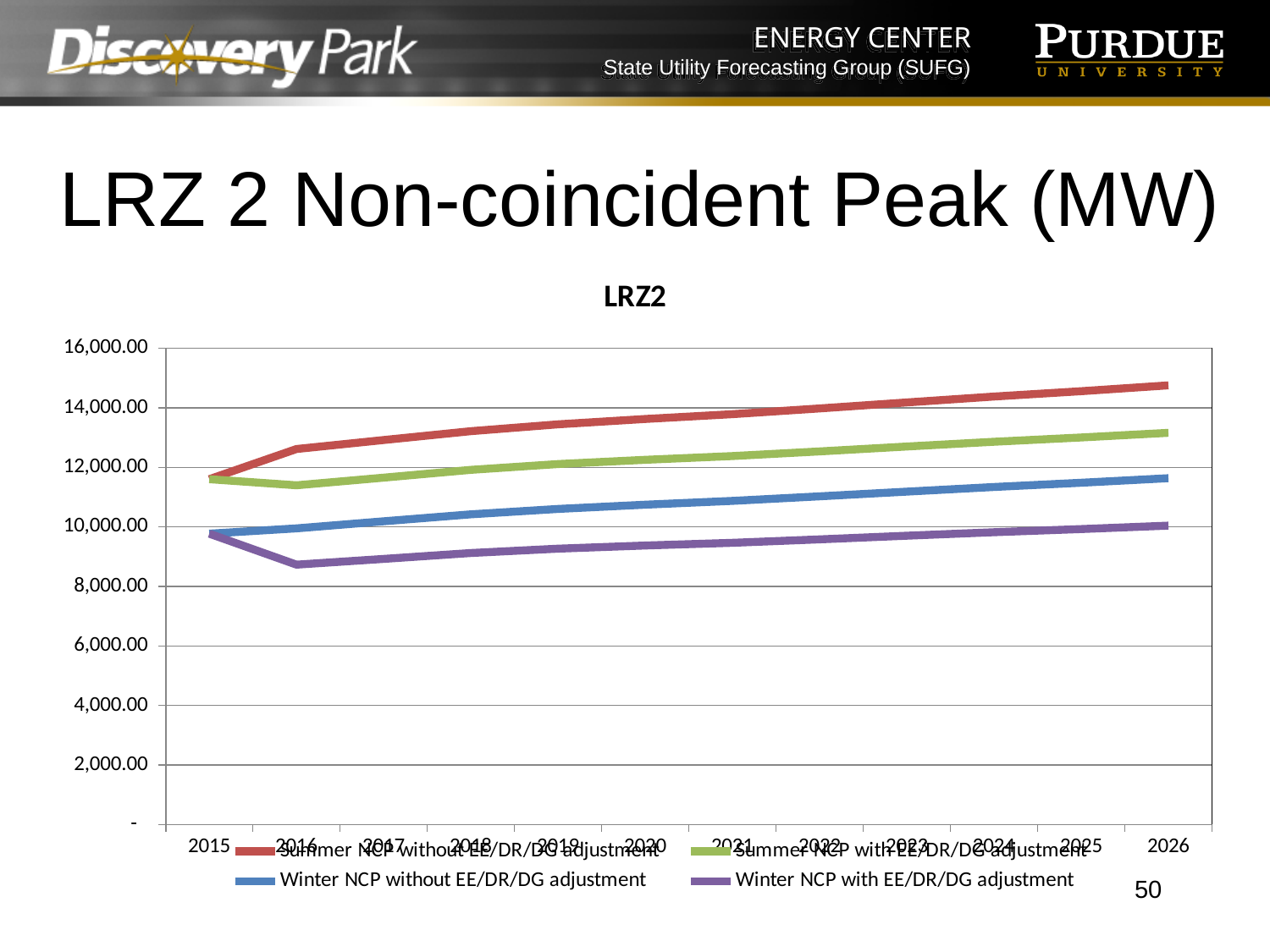
In 2026, which is larger: Summer NCP without EE/DR/DG adjustment or Winter NCP without EE/DR/DG adjustment? Summer NCP without EE/DR/DG adjustment Which series has the lowest values across the LRZ2 chart? Winter NCP with EE/DR/DG adjustment Is the value for Winter NCP with EE/DR/DG adjustment in 2016 greater or less than 10,000.00? less Does the Summer NCP without EE/DR/DG adjustment series rise or fall from 2015 to 2026? rise What colour is the line for Winter NCP with EE/DR/DG adjustment? Purple How many years are plotted along the x axis of the LRZ2 chart? 12 Is the value for Summer NCP without EE/DR/DG adjustment in 2026 greater or less than 14,000.00? greater Is the value for Summer NCP with EE/DR/DG adjustment in 2026 greater or less than 12,000.00? greater How many series does the legend of the LRZ2 chart list? 4 Which series has the highest values across the LRZ2 chart? Summer NCP without EE/DR/DG adjustment What type of chart is shown on the slide? Line chart